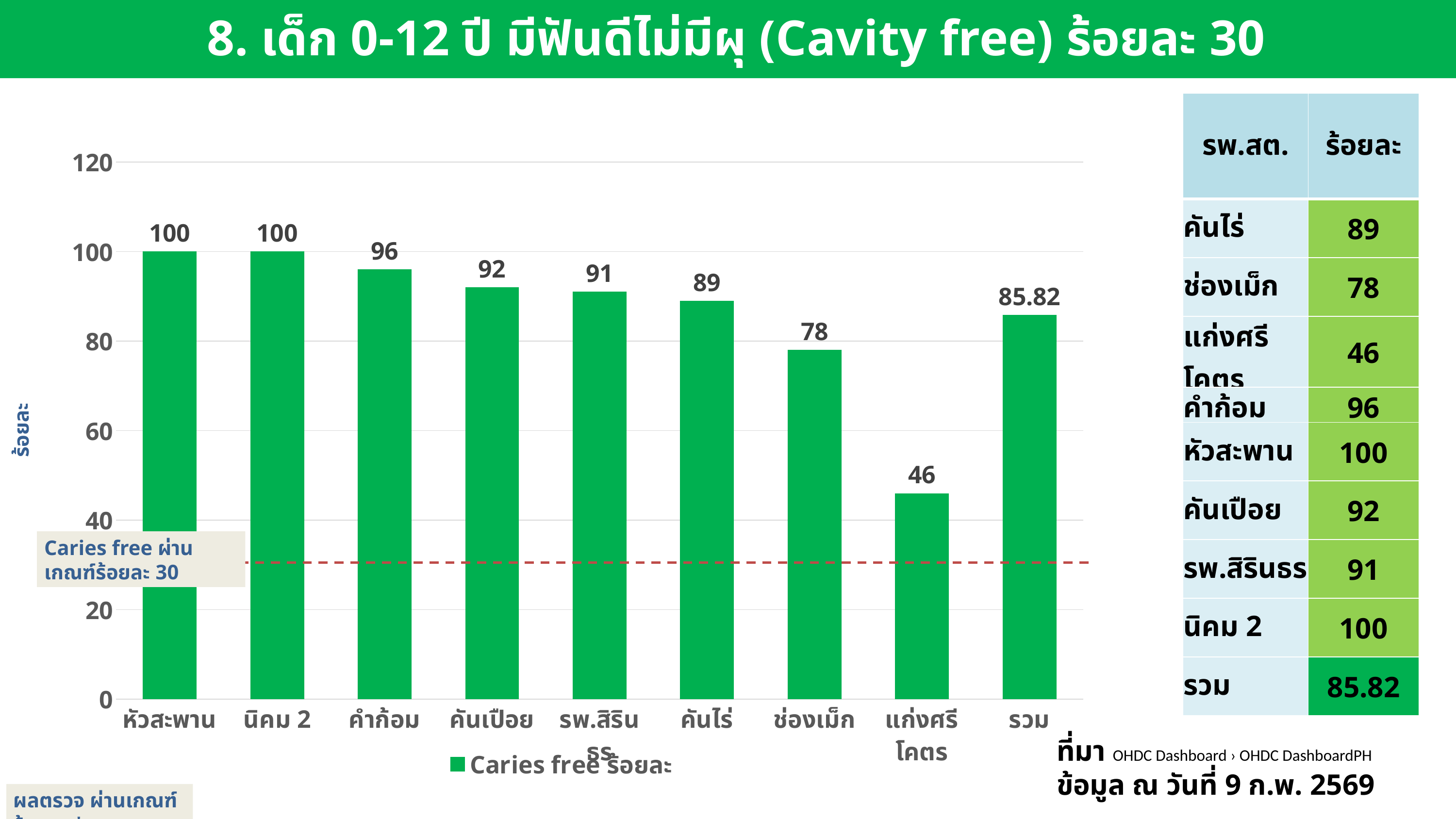
Is the value for แก่งศรีโคตร greater or less than 60? less What is the value for รวม? 85.82 Which category has the lowest value? แก่งศรีโคตร How many series does the legend list? 1 What is the difference between the values for คันเปือย and ช่องเม็ก? 14 What is the value for คำก้อม? 96 How many categories are shown on the x axis? 9 What is the value for ช่องเม็ก? 78 Which is larger, the value for คันไร่ or the value for รพ.สิรินธร? รพ.สิรินธร What is the legend entry for the series? Caries free ร้อยละ What is the value for แก่งศรีโคตร? 46 What kind of chart is shown? bar chart